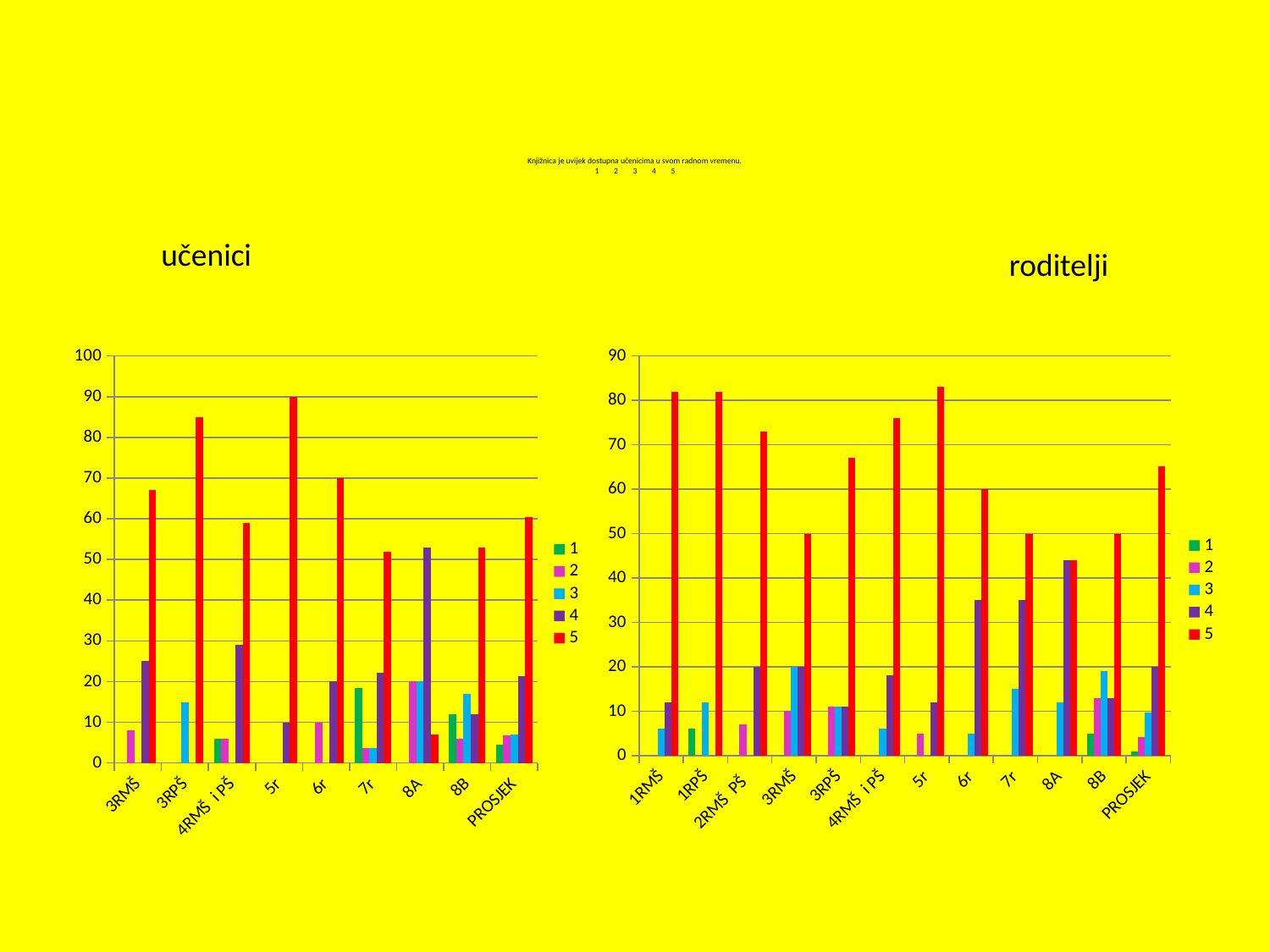
In the "učenici" chart, which category has the highest value for series 5? 5r In the "učenici" chart, what colour represents series 5 in the legend? red How many categories are shown on the x axis of the "učenici" chart? 9 What kind of chart is the "učenici" chart on the left? bar chart In the "učenici" chart, what is the value of series 5 for 6r? 70 In the "roditelji" chart, which is larger for series 5: 6r or 7r? 6r In the "učenici" chart, what is the value of series 5 for 5r? 90 In the "roditelji" chart, what is the value of series 5 for 6r? 60 How many series does the legend of the "roditelji" chart list? 5 In the "roditelji" chart, is the value of series 5 for 8A greater or less than 50? less How many categories are shown on the x axis of the "roditelji" chart? 12 In the "učenici" chart, is the value of series 5 for 3RPŠ greater or less than 80? greater